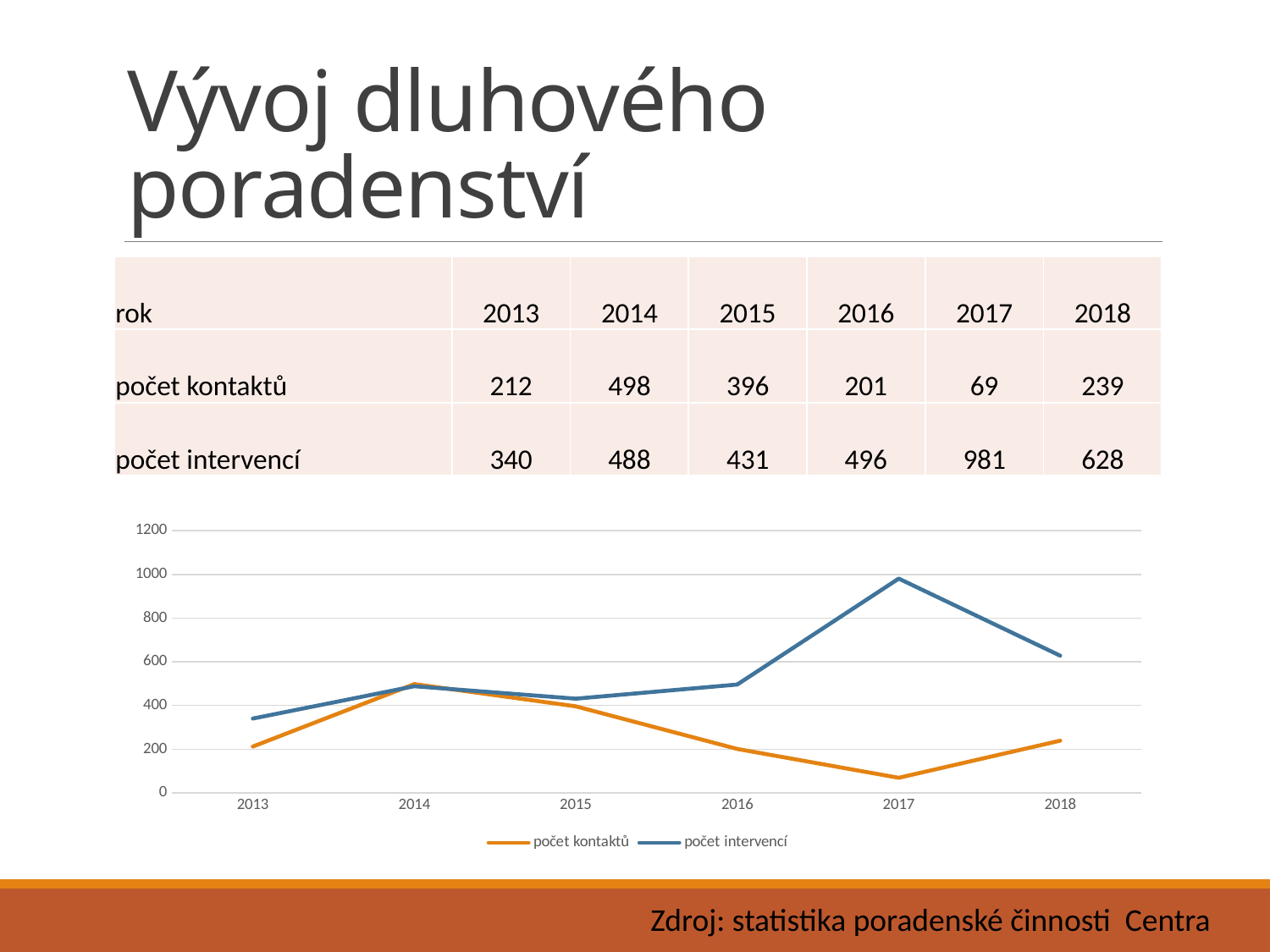
Does počet kontaktů rise or fall from 2014 to 2017? fall In which year is počet intervencí highest? 2017 What is the value of počet intervencí in 2017? 981 What is the value of počet kontaktů in 2014? 498 In which year is počet kontaktů lowest? 2017 Is the value for počet intervencí in 2018 greater or less than 600? greater How many years are plotted along the x axis of the chart? 6 Which is larger in 2013, počet kontaktů or počet intervencí? počet intervencí What kind of chart is shown on the slide? line chart How many series does the chart legend list? 2 Which colour is the line for počet kontaktů? orange What is the difference between počet intervencí and počet kontaktů in 2017? 912